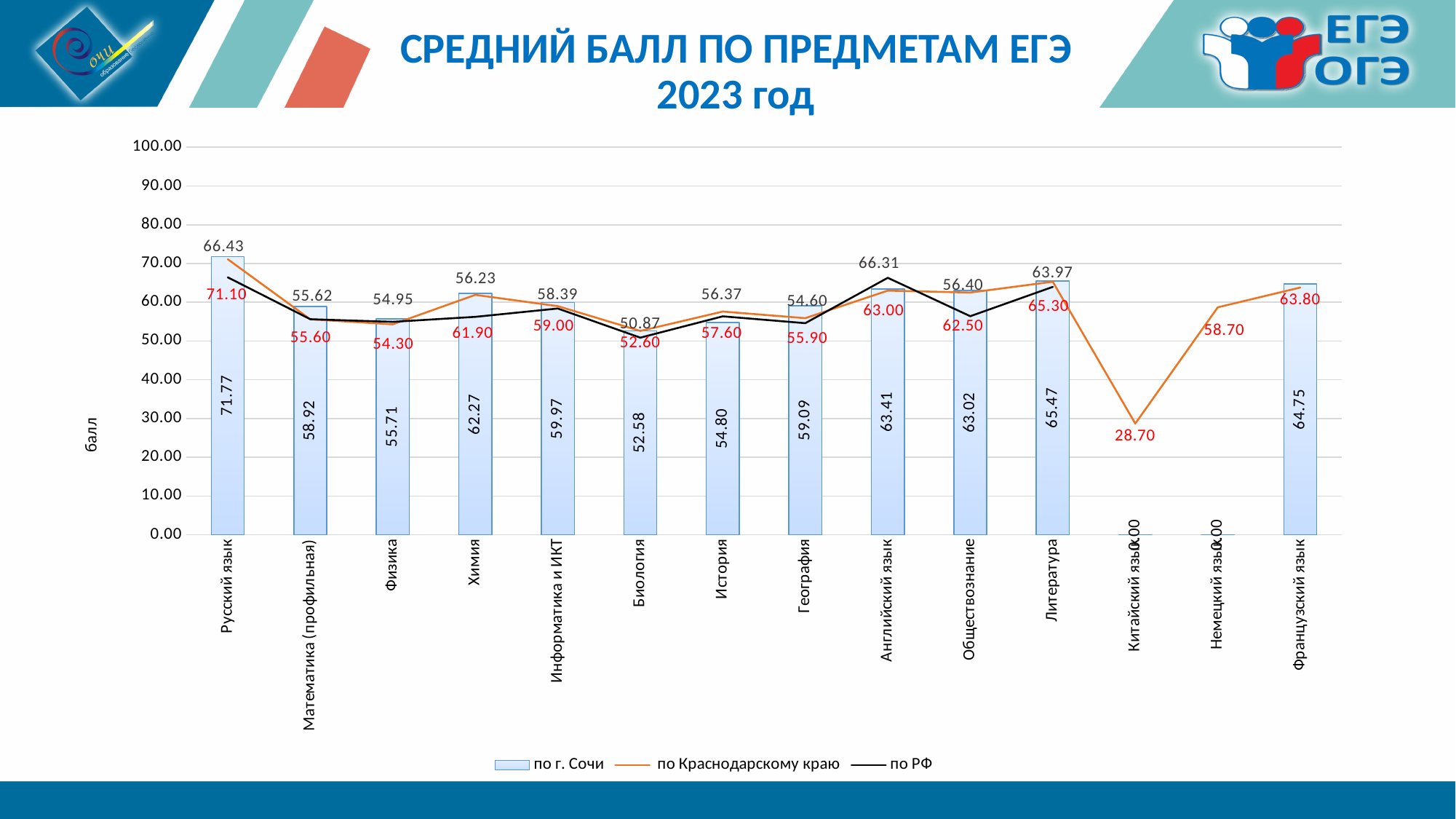
What is the value for Китайский язык in the series «по Краснодарскому краю»? 28.70 What is the label of the vertical axis? балл What is the value for Литература in the series «по г. Сочи»? 65.47 Which subject has the highest bar for «по г. Сочи»? Русский язык How many series does the legend list? 3 For Химия, which series has the larger value: «по г. Сочи» or «по РФ»? по г. Сочи What is the average score for Русский язык for the series «по г. Сочи»? 71.77 For Русский язык, what is the difference between the «по г. Сочи» value and the «по Краснодарскому краю» value? 0.67 For Английский язык, how much higher is the «по РФ» value than the «по Краснодарскому краю» value? 3.31 Which subject has the lowest value in the series «по Краснодарскому краю»? Китайский язык What is the value for Английский язык in the series «по РФ»? 66.31 How many subjects are shown on the x axis? 14